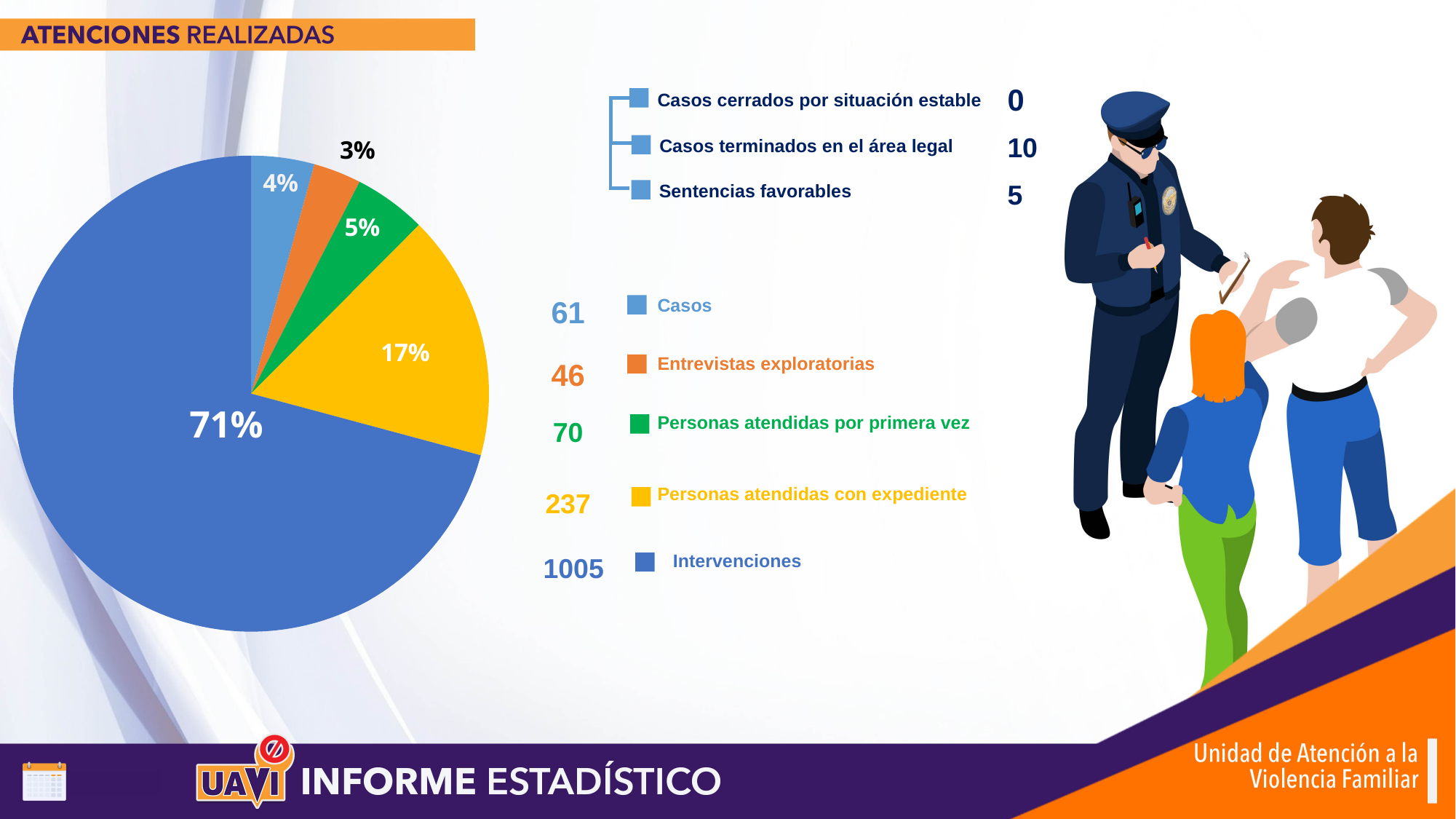
How many slices does the pie chart have? 5 What percentage of the pie does Entrevistas exploratorias represent? 3% What is the value shown for Personas atendidas por primera vez? 70 What kind of chart is shown on the slide? pie chart What percentage of the pie does Intervenciones represent? 71% What colour is the slice for Personas atendidas con expediente? yellow Which is larger, the value for Casos or the value for Entrevistas exploratorias? Casos What percentage of the pie does Personas atendidas con expediente represent? 17% What is the difference between the values for Intervenciones and Personas atendidas con expediente? 768 What is the value shown for Casos? 61 Which category has the largest slice of the pie? Intervenciones Which category has the smallest slice of the pie? Entrevistas exploratorias